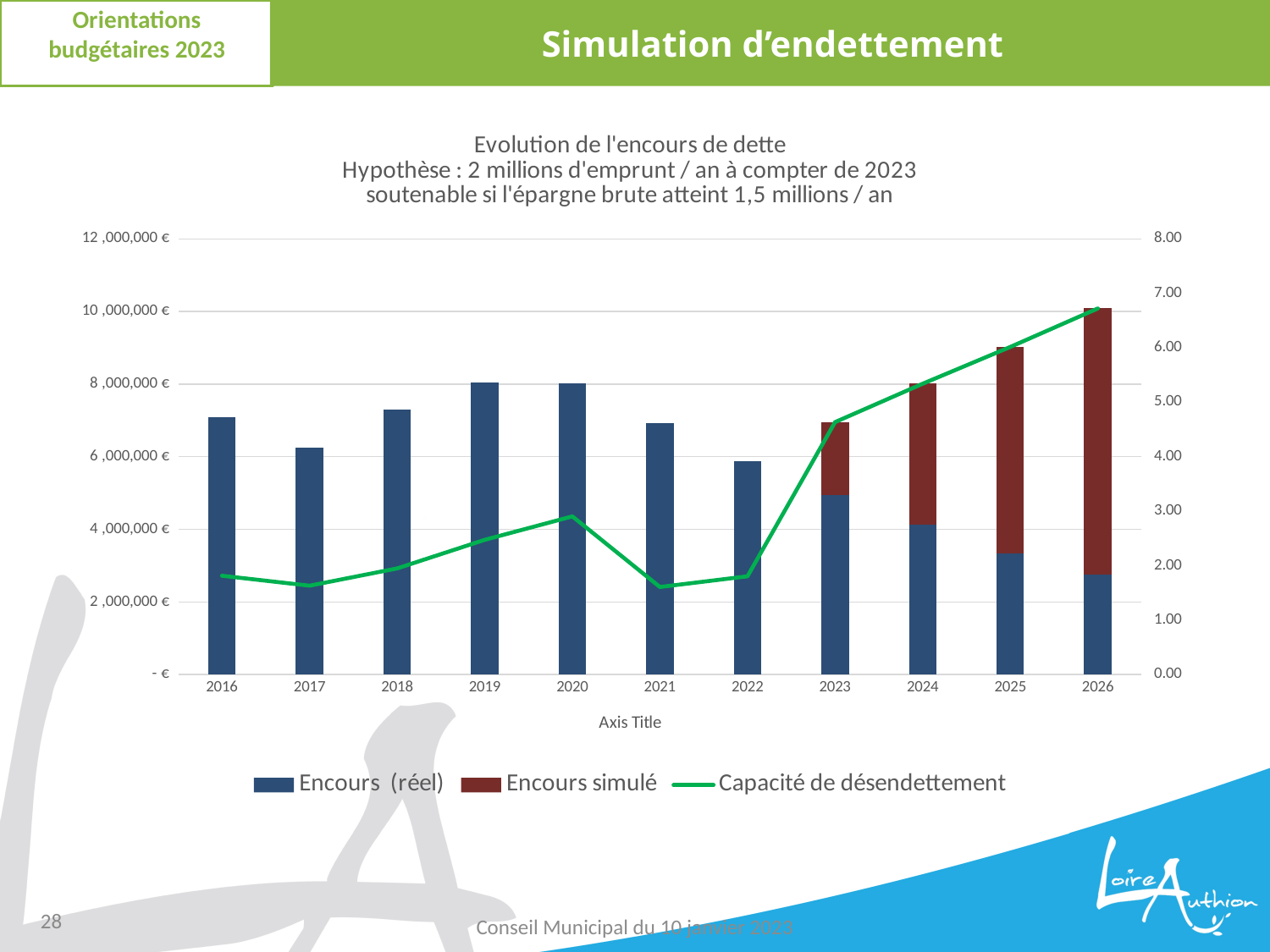
In which year does the Capacité de désendettement line reach its highest value? 2026 Is the Encours (réel) bar for 2016 greater or less than 6 ,000,000 €? greater Which year has the shortest bar? 2022 What kind of chart is shown on the slide? Bar chart with a line Does the Capacité de désendettement line rise or fall from 2022 to 2026? rise Is the Capacité de désendettement value for 2026 greater or less than 6.00? greater Which series is drawn as a green line in the chart? Capacité de désendettement Which year has the tallest total bar? 2026 What is the first line of the chart title? Evolution de l'encours de dette How many years are shown on the x axis of the chart? 11 Is the Capacité de désendettement value for 2021 greater or less than 2.00? less How many series does the chart legend list? 3